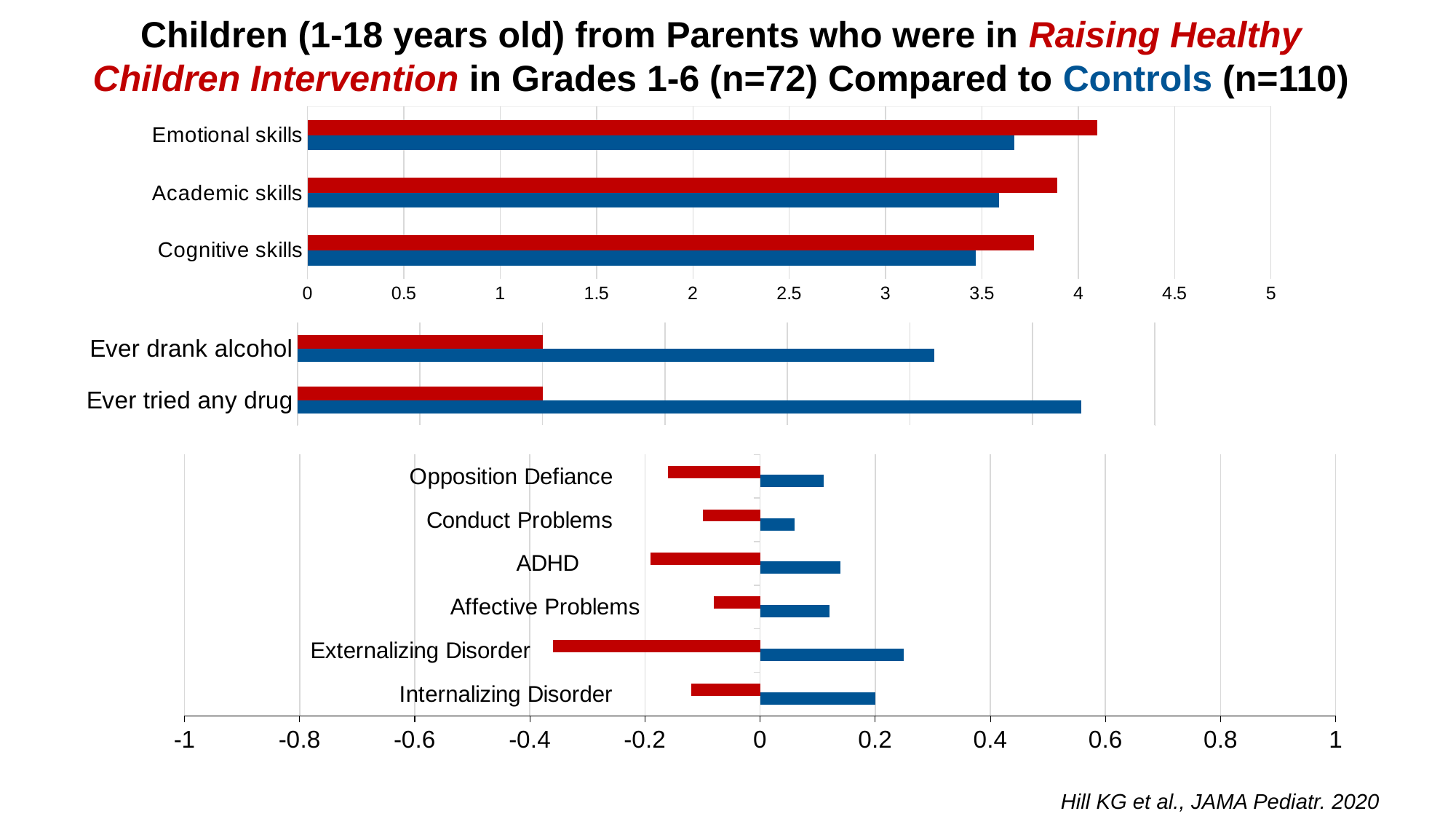
In the bottom chart, which category has the highest Controls (blue) value? Externalizing Disorder In the bottom chart, which category has the lowest Controls (blue) value? Conduct Problems In the bottom chart (disorders), how many categories are shown? 6 In the top chart (skills), how many categories are shown? 3 In the top chart, which category has the lowest Controls (blue) value? Cognitive skills In the middle chart, for Ever tried any drug, which group has the larger value, the intervention (red) or Controls (blue)? Controls (blue) In the middle chart (alcohol and drug use), how many categories are shown? 2 What kind of chart is the top chart showing Emotional, Academic and Cognitive skills? bar chart In the bottom chart, is the Raising Healthy Children intervention (red) value for Externalizing Disorder greater or less than -0.2? less In the top chart, is the Raising Healthy Children intervention (red) value for Emotional skills greater or less than 4? greater In the top chart, which category has the highest Raising Healthy Children intervention (red) value? Emotional skills In the top chart, is the Controls (blue) value for Academic skills greater or less than 3.5? greater